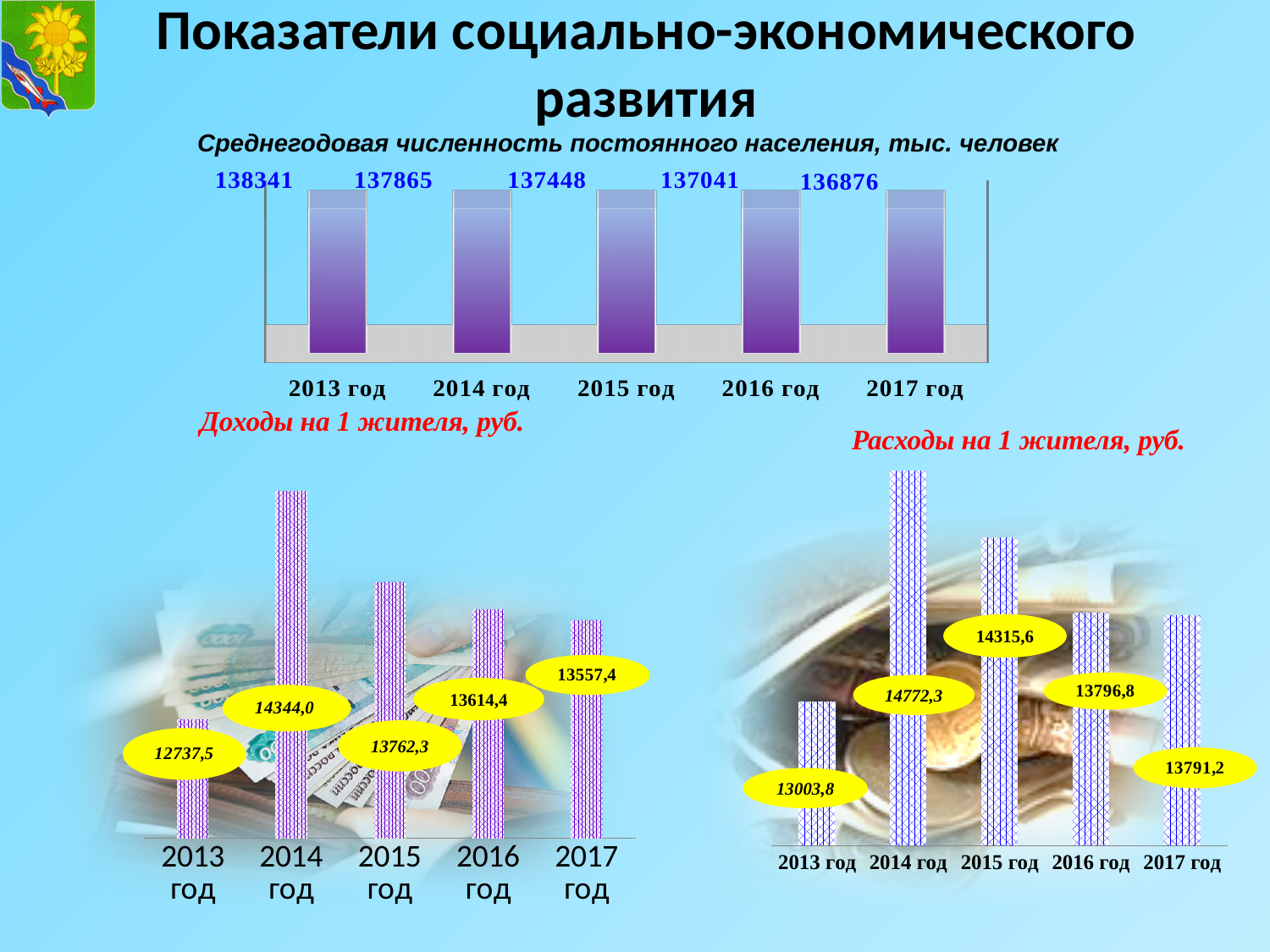
In the chart 'Расходы на 1 жителя, руб.', what is the value for 2015 год? 14315,6 How many years are shown in the chart 'Среднегодовая численность постоянного населения, тыс. человек'? 5 In the chart 'Среднегодовая численность постоянного населения, тыс. человек', what is the value for 2017 год? 136876 What type of chart is 'Расходы на 1 жителя, руб.'? bar chart In the chart 'Среднегодовая численность постоянного населения, тыс. человек', do the values rise or fall from 2013 год to 2017 год? fall In the chart 'Доходы на 1 жителя, руб.', what is the value for 2014 год? 14344,0 In the chart 'Доходы на 1 жителя, руб.', which year has the lowest value? 2013 год In the chart 'Доходы на 1 жителя, руб.', which is larger, the value for 2015 год or 2016 год? 2015 год In the chart 'Среднегодовая численность постоянного населения, тыс. человек', what is the difference between the values for 2013 год and 2014 год? 476 In the chart 'Расходы на 1 жителя, руб.', which year has the highest value? 2014 год In the chart 'Расходы на 1 жителя, руб.', what is the value for 2013 год? 13003,8 In the chart 'Среднегодовая численность постоянного населения, тыс. человек', what is the value for 2013 год? 138341